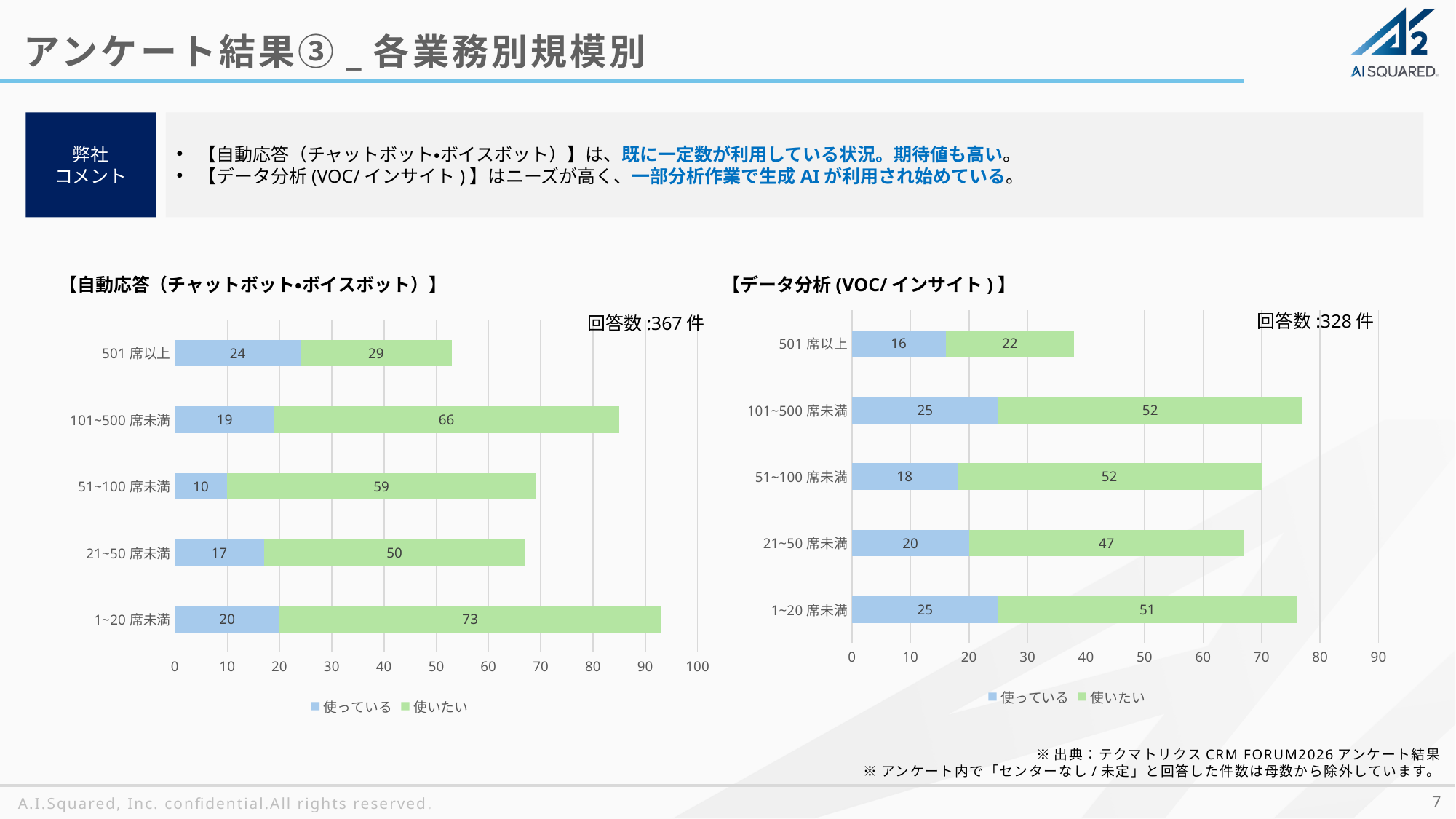
In the 【データ分析(VOC/インサイト)】 chart, which category has the lowest 使いたい value? 501席以上 In the 【自動応答（チャットボット•ボイスボット）】 chart, what is the difference between the 使いたい values for 1~20席未満 and 501席以上? 44 In the 【自動応答（チャットボット•ボイスボット）】 chart, what is the 使っている value for 501席以上? 24 In the 【データ分析(VOC/インサイト)】 chart, what is the 使いたい value for 21~50席未満? 47 In the 【データ分析(VOC/インサイト)】 chart, which is larger: the 使っている value for 101~500席未満 or for 501席以上? 101~500席未満 In the 【データ分析(VOC/インサイト)】 chart, what is the total of the stacked bar for 1~20席未満? 76 In the 【自動応答（チャットボット•ボイスボット）】 chart, what is the 使いたい value for 1~20席未満? 73 What type of chart is the 【データ分析(VOC/インサイト)】 chart? Stacked bar chart In the 【自動応答（チャットボット•ボイスボット）】 chart, which category has the lowest 使っている value? 51~100席未満 How many series does the legend of the 【自動応答（チャットボット•ボイスボット）】 chart list? 2 In the 【自動応答（チャットボット•ボイスボット）】 chart, what is the total of the stacked bar for 101~500席未満? 85 In the 【データ分析(VOC/インサイト)】 chart, what is the 使っている value for 51~100席未満? 18